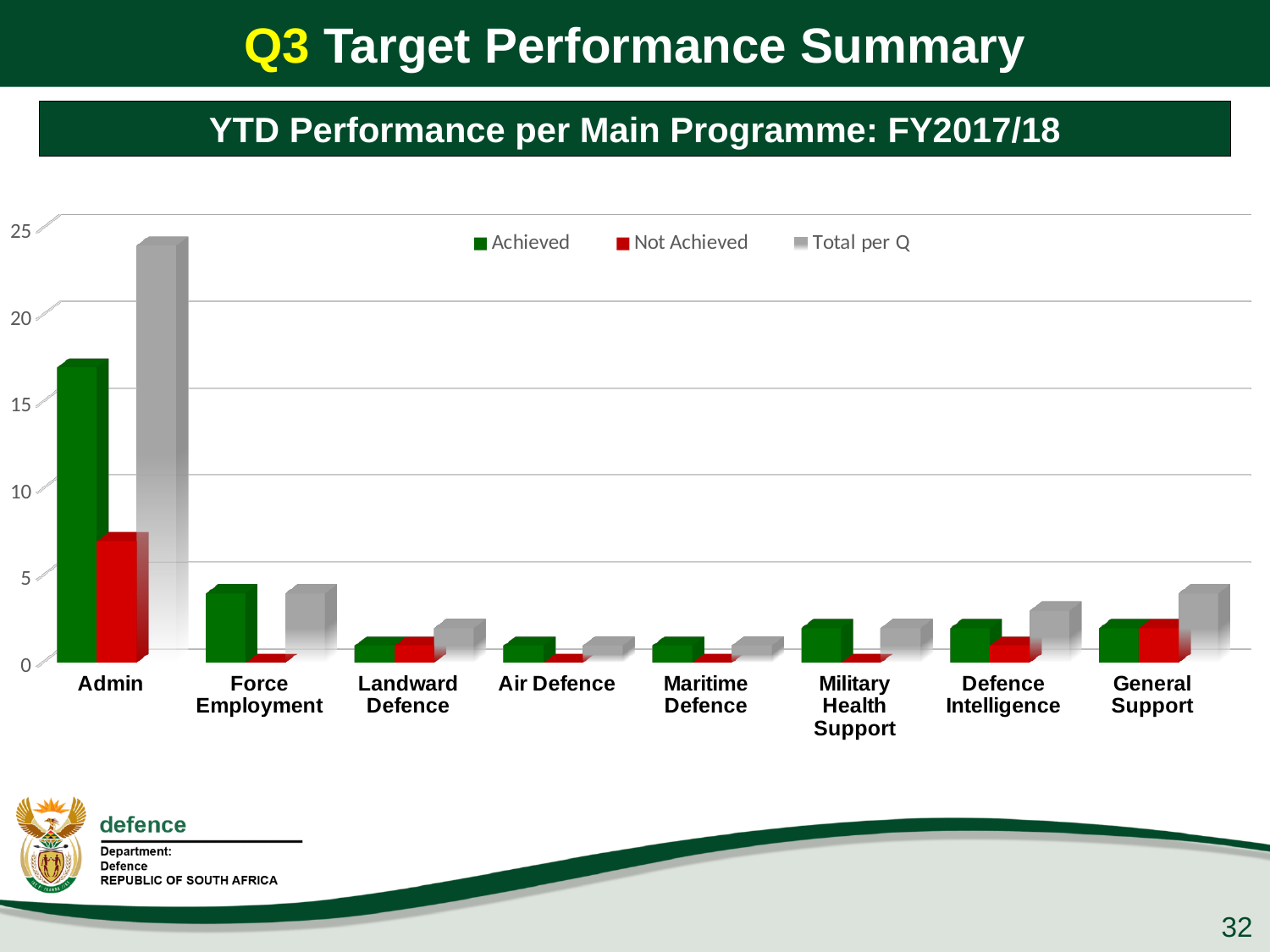
What kind of chart is shown on the slide? Bar chart Which has the larger Achieved value: Force Employment or Landward Defence? Force Employment Is the Achieved value for Admin greater or less than 15? greater How many series does the legend list? 3 For Admin, which is larger: the Achieved value or the Not Achieved value? Achieved Is the Not Achieved value for Admin greater or less than 5? greater Which programme has the highest Total per Q value? Admin Is the Total per Q value for Force Employment greater or less than 5? less How many main programmes (categories) are shown on the x axis? 8 Which programme has the highest Achieved value? Admin What is the title of the chart? YTD Performance per Main Programme: FY2017/18